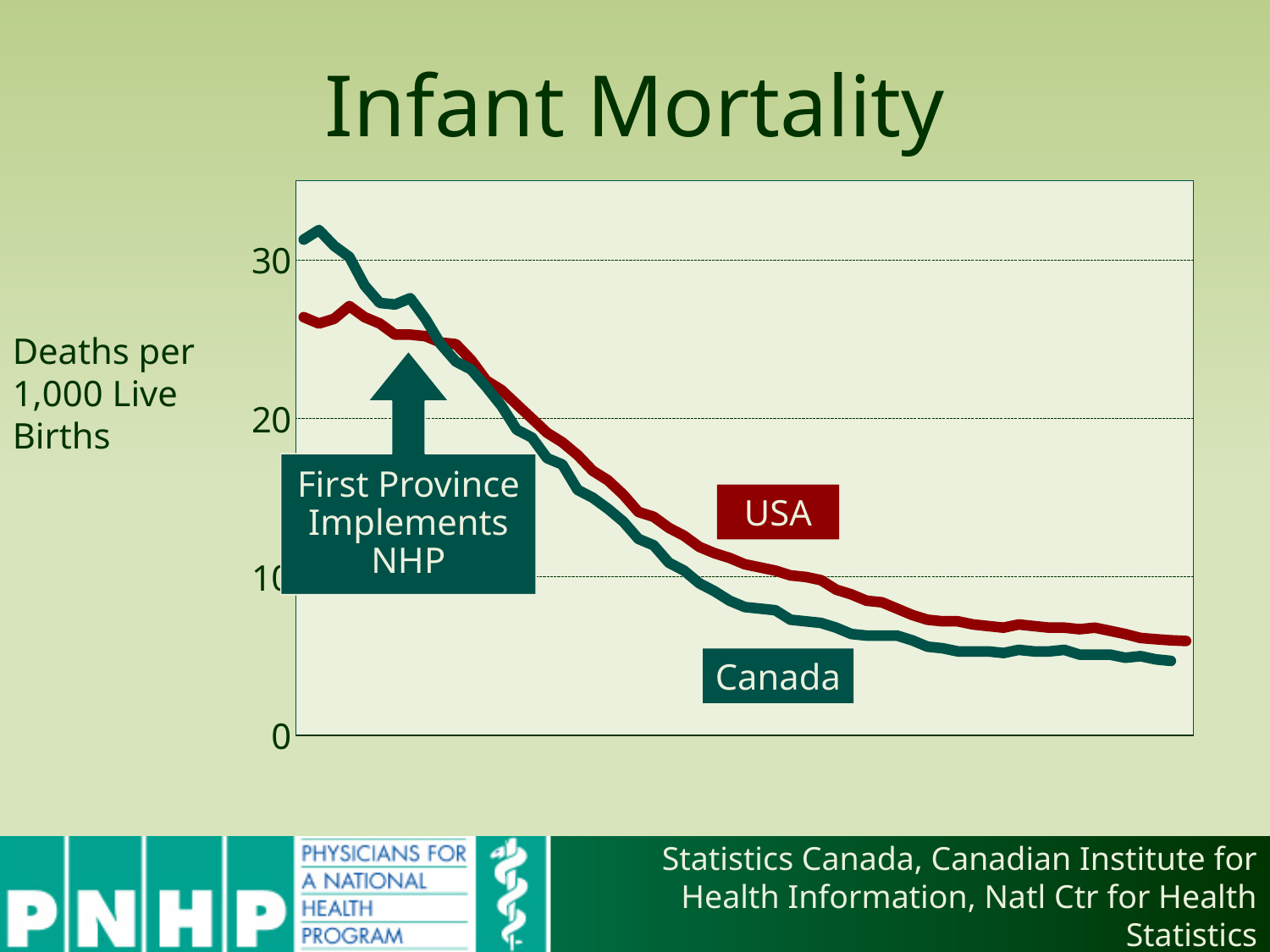
At the right end of the chart, is the value for USA greater or less than 10? less At the right end of the chart, which series has the higher value, USA or Canada? USA What is the title of the chart? Infant Mortality At the left end of the chart, is the value for USA greater or less than 30? less Does the Canada line rise or fall along the x axis? fall At the left end of the chart, is the value for Canada greater or less than 30? greater How many series are plotted on the chart? 2 Does the USA line rise or fall along the x axis? fall What does the y axis of the chart measure? Deaths per 1,000 Live Births At the left end of the chart, which series has the higher value, USA or Canada? Canada What kind of chart is shown on the slide? line chart